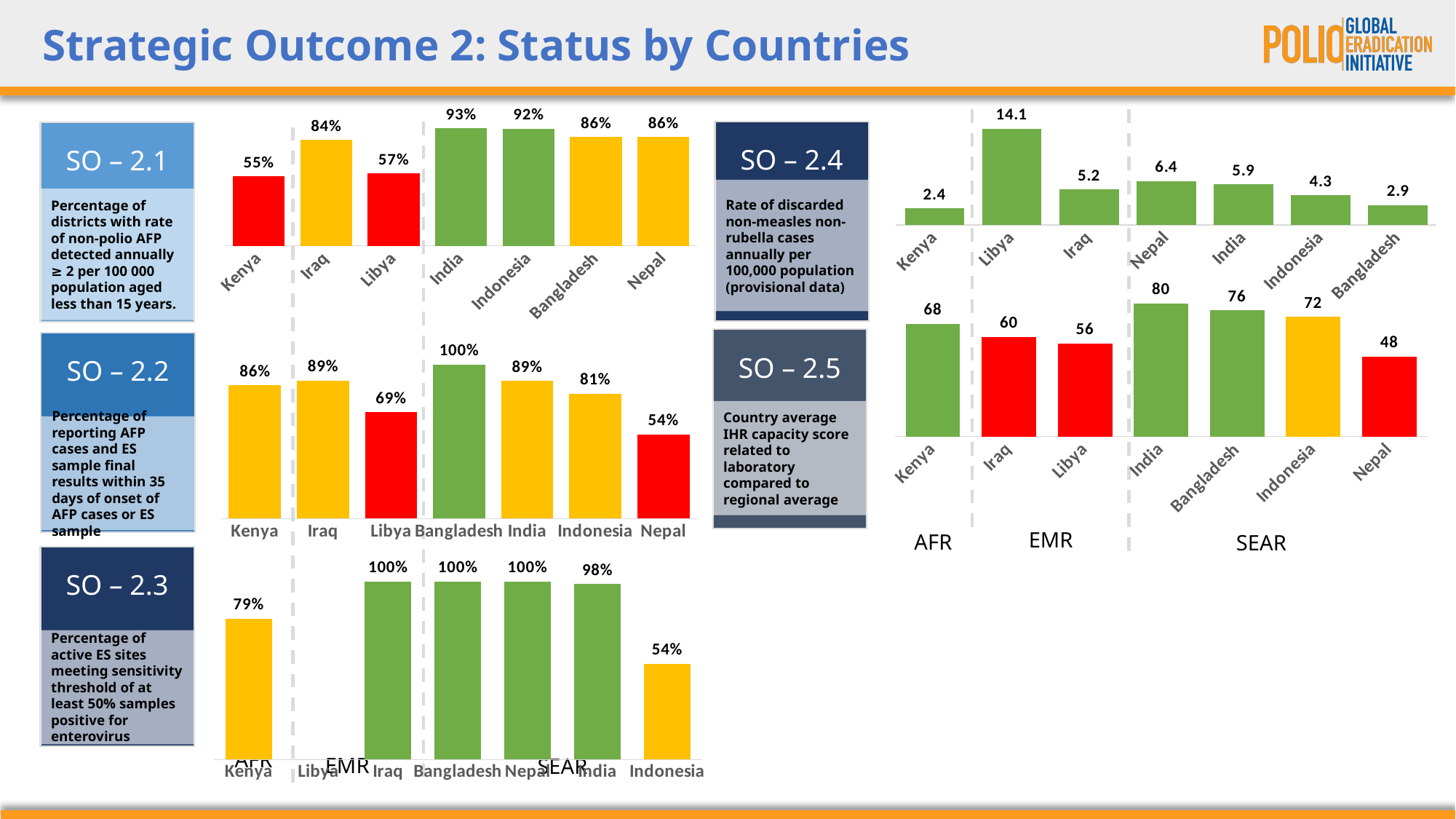
In the SO – 2.3 chart, what is the value for Indonesia? 54% In the SO – 2.5 chart, which is larger, the value for Iraq or the value for Libya? Iraq In the SO – 2.3 chart, how many countries are shown? 7 In the SO – 2.1 chart, which country has the highest value? India In the SO – 2.2 chart, what is the difference between the values for Bangladesh and Libya? 31% What type of chart is the SO – 2.5 chart? Bar chart In the SO – 2.4 chart, which country has the lowest value? Kenya In the SO – 2.2 chart, which country has the lowest value? Nepal In the SO – 2.1 chart, what is the value for Kenya? 55% In the SO – 2.4 chart, what is the value for Libya? 14.1 In the SO – 2.2 chart, what is the value for Nepal? 54% In the SO – 2.5 chart, what is the difference between the values for India and Nepal? 32